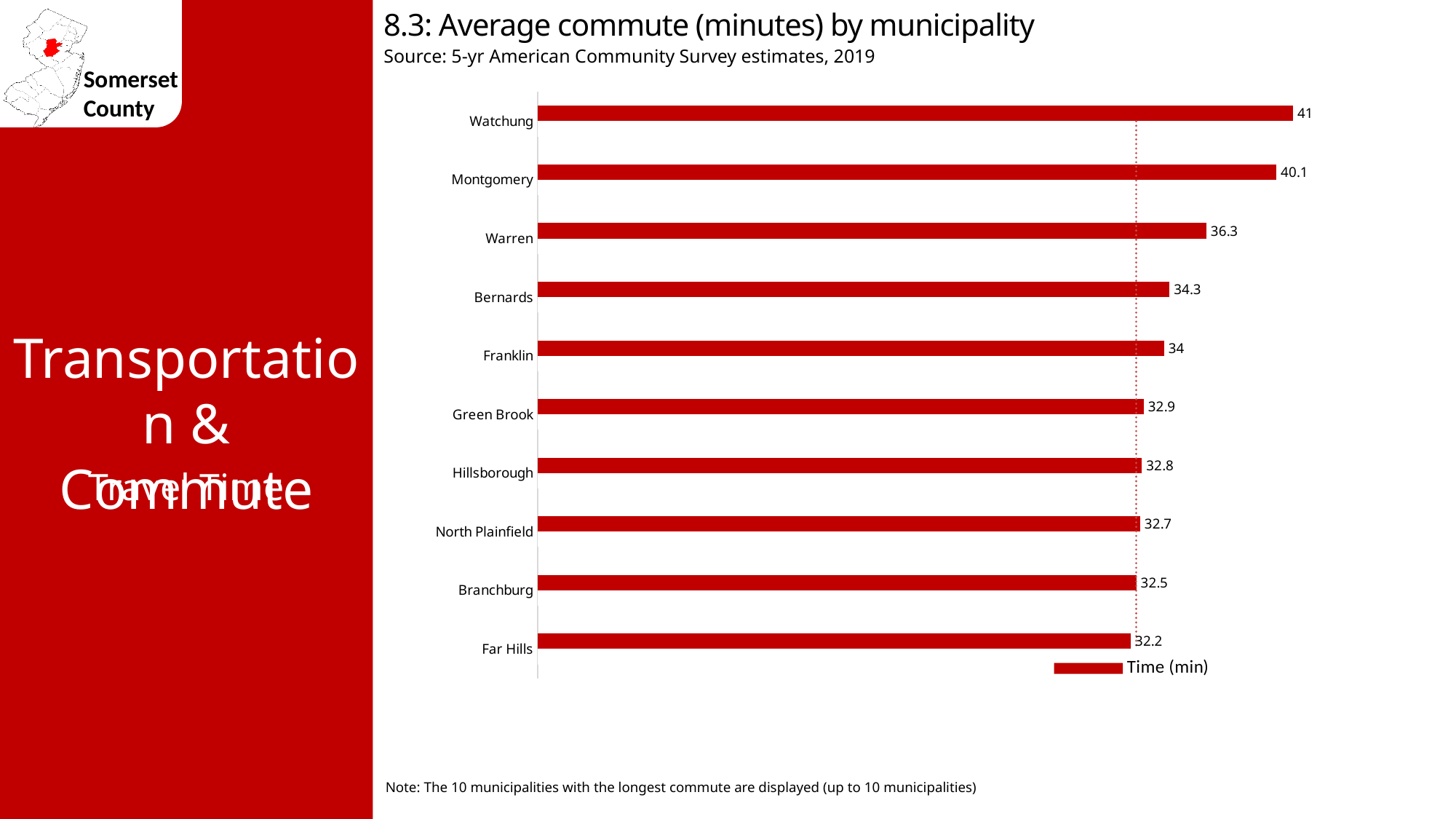
What type of chart is shown? Bar chart Which municipality has the longest average commute? Watchung What is the difference in average commute time between Montgomery and Warren? 3.8 What is the average commute time for Hillsborough? 32.8 What is the average commute time for Warren? 36.3 What is the legend entry for the series in the chart? Time (min) Which has a longer average commute, Bernards or Franklin? Bernards How many municipalities are shown in the chart? 10 How many series does the legend list? 1 What is the average commute time for Watchung? 41 Which municipality shown has the shortest average commute? Far Hills What is the difference in average commute time between Watchung and Far Hills? 8.8